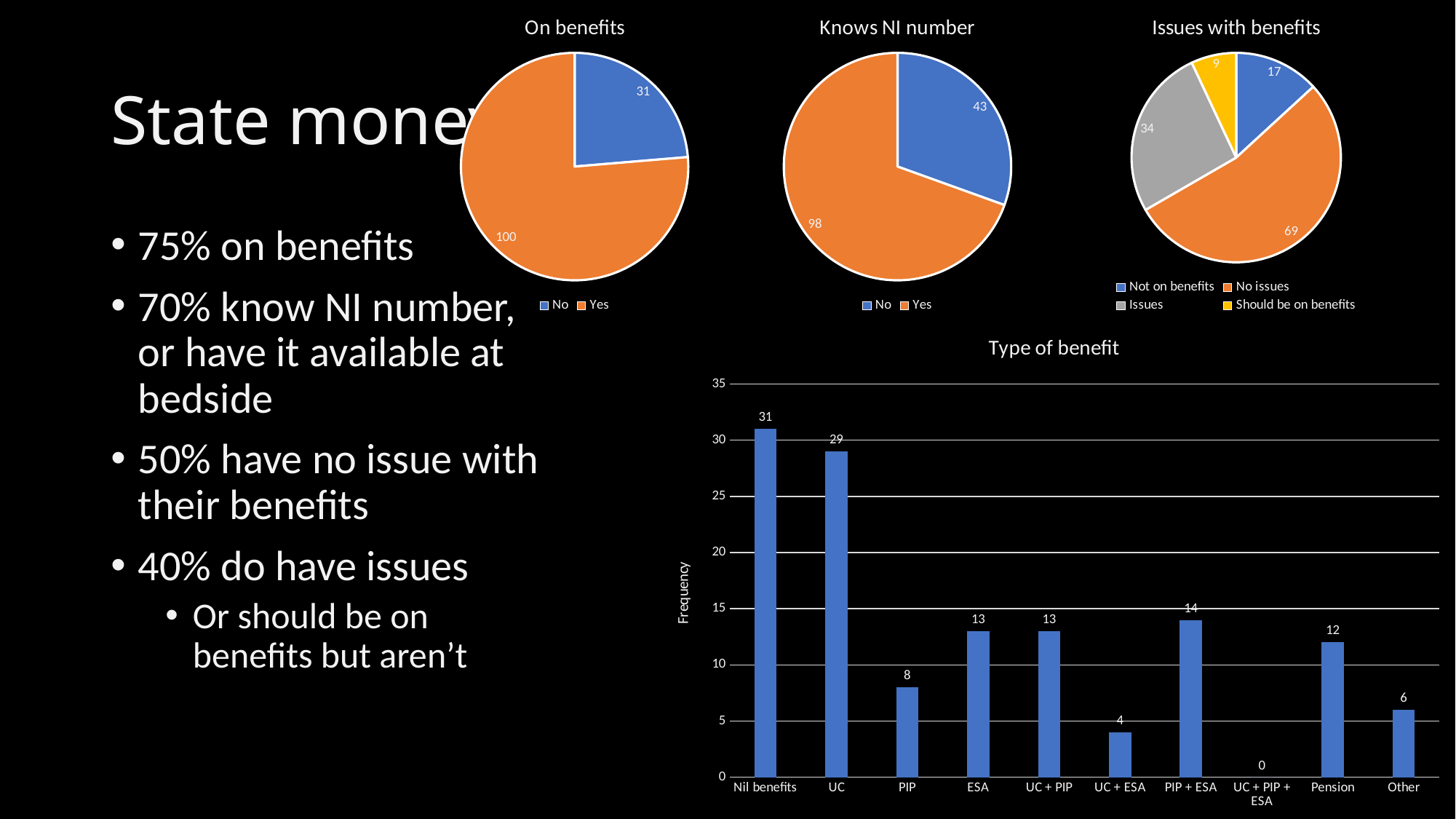
In the 'Knows NI number' pie chart, what is the difference between Yes and No? 55 In the 'Type of benefit' chart, what is the frequency for PIP + ESA? 14 How many categories does the 'Issues with benefits' legend list? 4 In the 'Type of benefit' chart, which category has a frequency of 0? UC + PIP + ESA In the 'Type of benefit' chart, how many categories are shown on the x axis? 10 In the 'Type of benefit' chart, which category has the highest frequency? Nil benefits In the 'On benefits' pie chart, what is the value for No? 31 In the 'On benefits' pie chart, what is the value for Yes? 100 In the 'Issues with benefits' pie chart, which category has the smallest slice? Should be on benefits What kind of chart is 'Type of benefit'? Bar chart In the 'Knows NI number' pie chart, what is the value for No? 43 In the 'Issues with benefits' pie chart, what is the value for Issues? 34